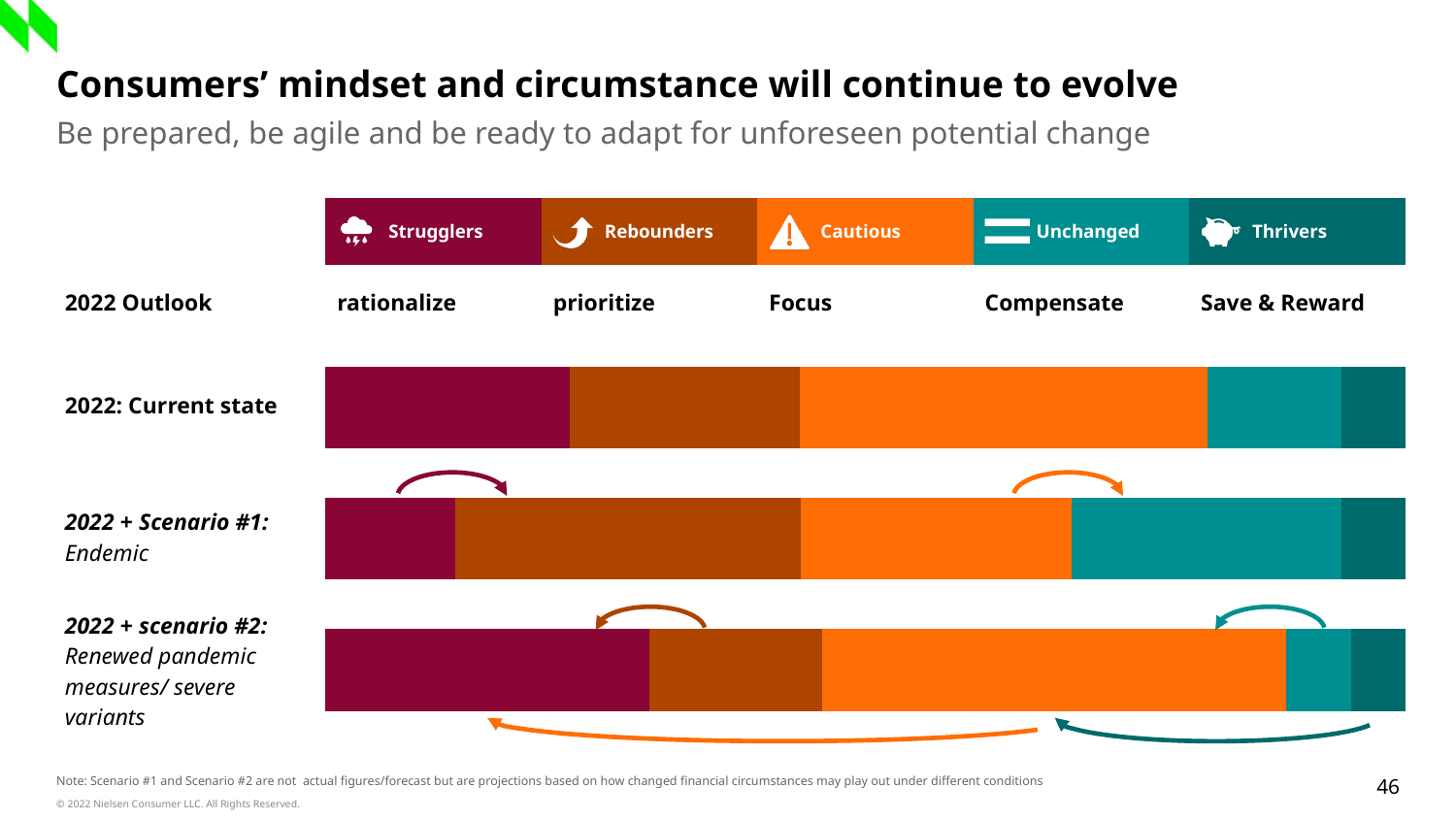
In the '2022: Current state' bar, which segment takes up the smallest share? Thrivers In the '2022: Current state' bar, which is larger, the Cautious segment or the Unchanged segment? Cautious In the '2022 + scenario #2' bar, which segment is the largest? Cautious Which colour is used for the Cautious segment in the chart? orange What kind of chart is used to show the consumer segments across the three scenarios? stacked bar chart How many bars (scenario rows) are shown in the chart? 3 In the '2022 + Scenario #1: Endemic' bar, which segment is the smallest? Thrivers Is the Unchanged segment larger in the '2022: Current state' bar or in the '2022 + scenario #2' bar? 2022: Current state Is the Strugglers segment larger in the '2022: Current state' bar or in the '2022 + Scenario #1: Endemic' bar? 2022: Current state How many consumer segments does the legend at the top of the chart list? 5 In the '2022 + Scenario #1: Endemic' bar, which segment is the largest? Rebounders In the '2022: Current state' bar, which segment takes up the largest share? Cautious